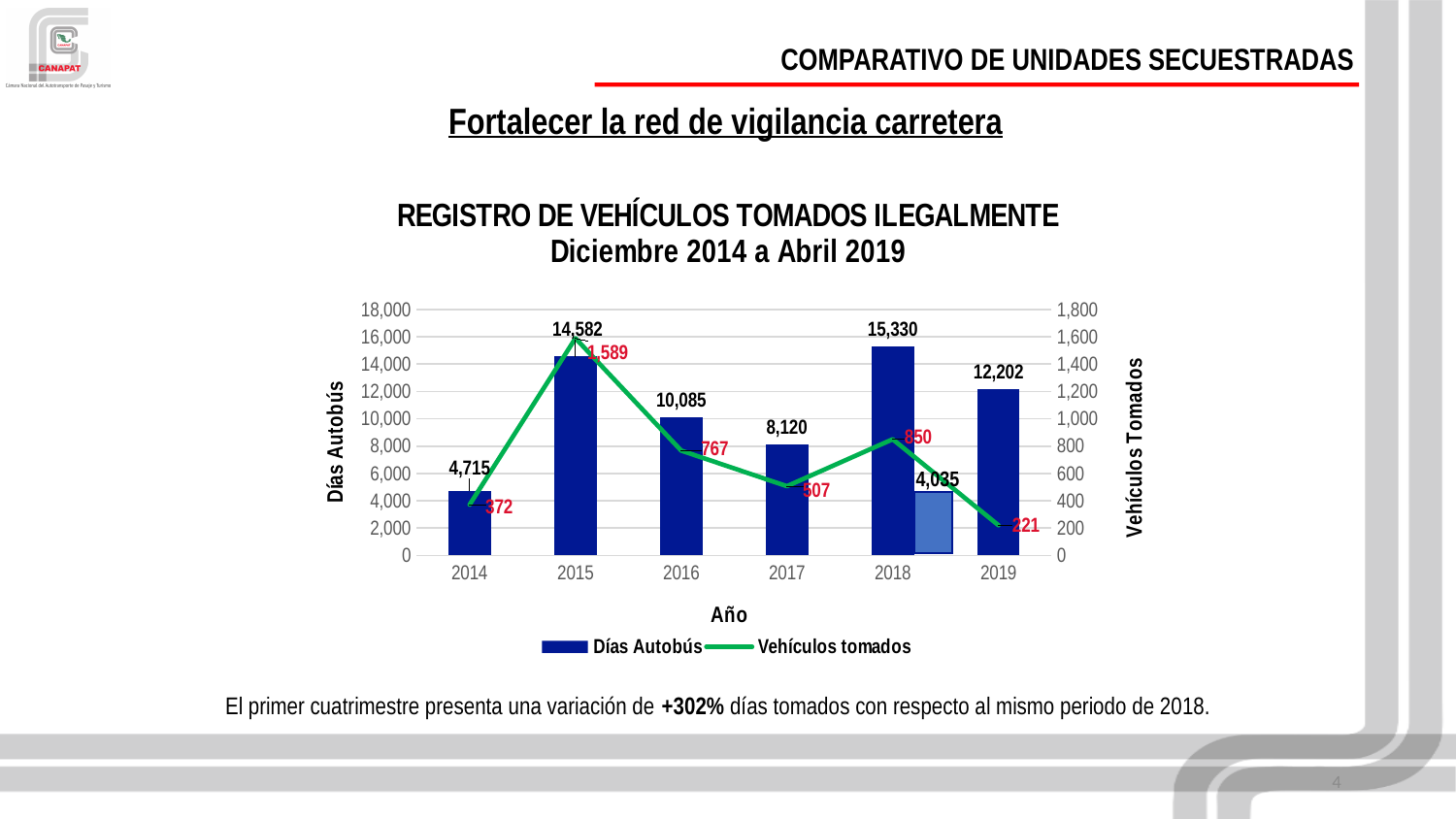
What is the value of Vehículos tomados for 2019? 221 Which is larger, Vehículos tomados in 2017 or in 2018? 2018 What is the value of Días Autobús for 2019? 12,202 What is the value of Días Autobús for 2015? 14,582 What is the difference in Días Autobús between 2016 and 2017? 1,965 What is the value of Vehículos tomados for 2016? 767 Which year has the highest value of Vehículos tomados? 2015 Which year has the highest value of Días Autobús? 2018 How many years are shown on the x axis? 6 How many series does the legend list? 2 What is the label of the right-hand vertical axis? Vehículos Tomados Which year has the lowest value of Vehículos tomados? 2019